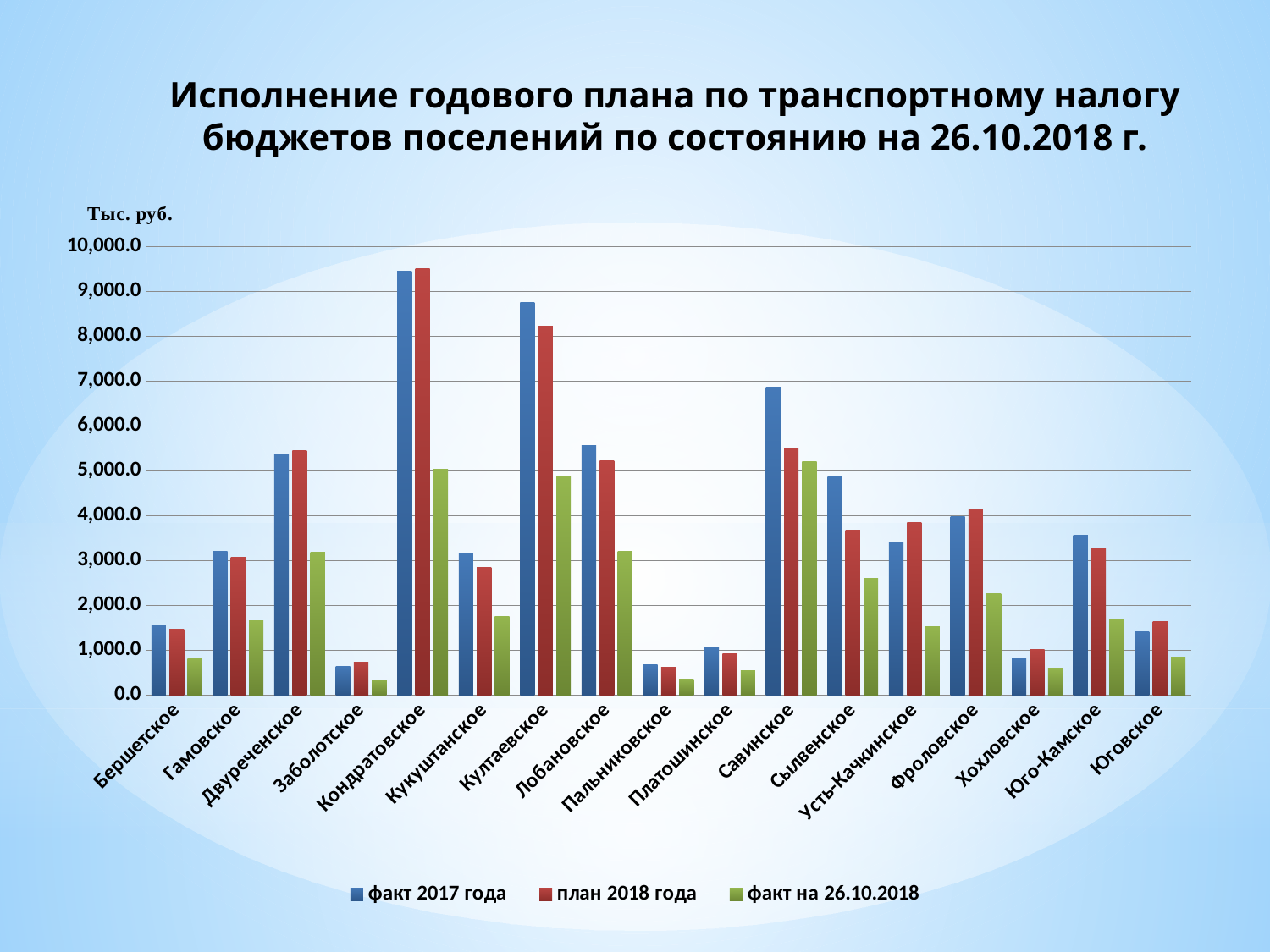
Which settlement has the highest value for the series "факт 2017 года"? Кондратовское Is the value for Лобановское in the series "факт 2017 года" greater or less than 5,000.0? greater Is the value for Савинское in the series "факт 2017 года" greater or less than 6,000.0? greater Is the value for Кондратовское in the series "план 2018 года" greater or less than 9,000.0? greater For Усть-Качкинское, which is larger: "факт 2017 года" or "план 2018 года"? план 2018 года How many series does the legend list? 3 For Култаевское, which is larger: "факт 2017 года" or "план 2018 года"? факт 2017 года What kind of chart is shown on the slide? bar chart How many settlements (categories) are shown on the x axis? 17 What unit is indicated above the vertical axis? Тыс. руб. Which settlement has the highest value for the series "план 2018 года"? Кондратовское